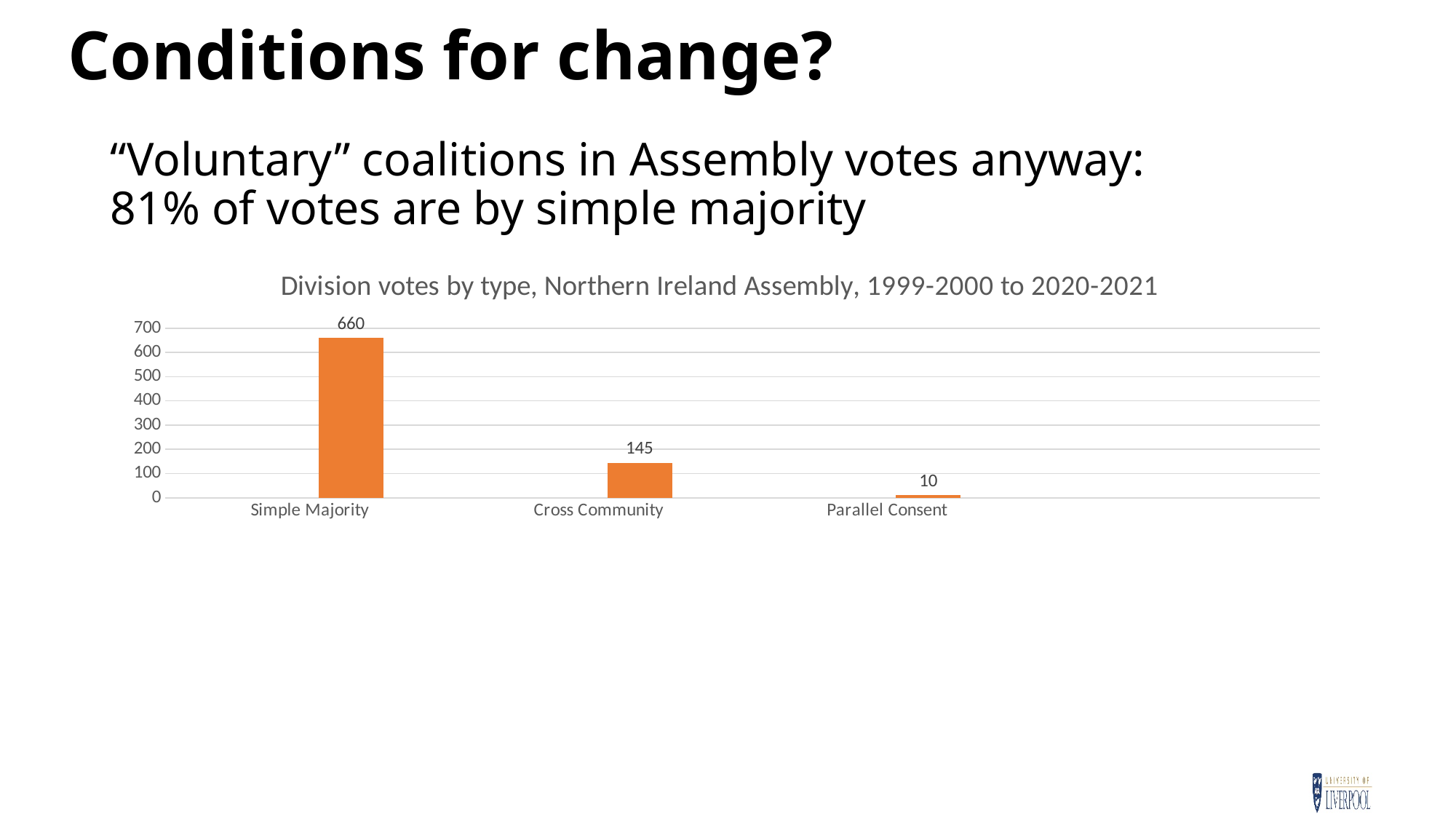
What kind of chart is shown on the slide? bar chart Which category has the lowest value? Parallel Consent What is the value for Simple Majority? 660 What is the value for Cross Community? 145 What is the value for Parallel Consent? 10 How many categories are shown on the x axis? 3 What is the title of the chart? Division votes by type, Northern Ireland Assembly, 1999-2000 to 2020-2021 Which is larger, the value for Cross Community or the value for Parallel Consent? Cross Community What is the difference between the values for Simple Majority and Cross Community? 515 Which category has the highest value? Simple Majority What is the difference between the values for Cross Community and Parallel Consent? 135 Is the value for Simple Majority greater or less than 600? greater